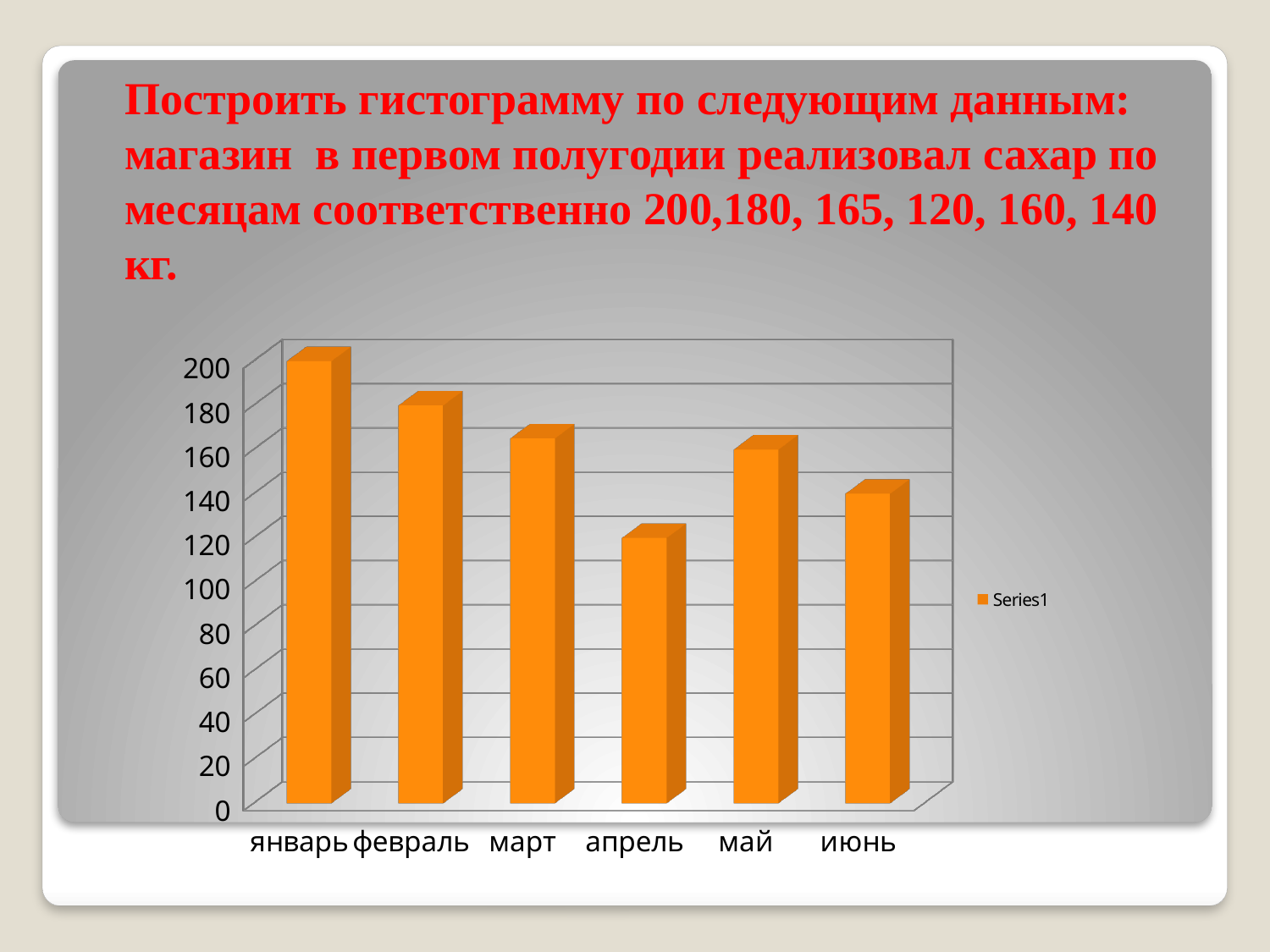
What is the difference between the values for январь and июнь? 60 How many months (categories) are shown on the x axis of the chart? 6 How many series does the chart legend list? 1 What type of chart is shown on the slide? bar chart What is the name of the series shown in the chart legend? Series1 Which month has the highest bar in the chart? январь What is the value for январь (January) in the chart? 200 Is the value for июнь greater or less than 160? less What is the value for март (March) in the chart? 165 Which is larger, the value for февраль or the value for май? февраль What is the value for апрель (April) in the chart? 120 Which month has the lowest bar in the chart? апрель